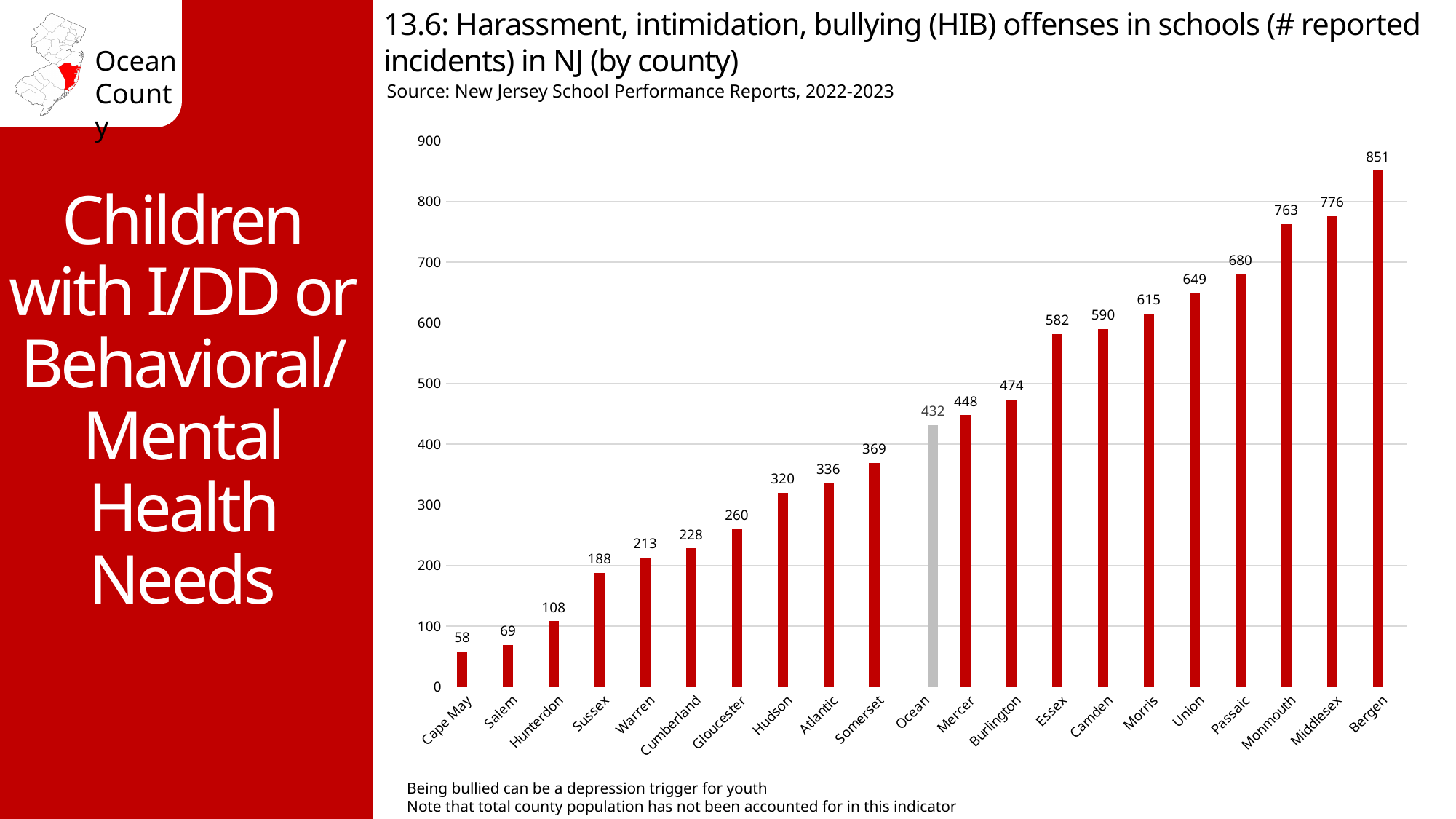
What kind of chart is shown on the slide? Bar chart Which county has the lowest number of reported HIB incidents? Cape May What is the difference in reported HIB incidents between Middlesex and Monmouth? 13 Which bar is shown in a different colour (grey) from the others? Ocean Which county has the highest number of reported HIB incidents? Bergen What is the difference in reported HIB incidents between Bergen and Ocean? 419 What is the number of reported HIB incidents for Ocean County? 432 Is the value for Monmouth greater or less than 700? greater Do the values rise or fall moving from left to right along the x axis? Rise How many counties are shown on the chart? 21 What is the number of reported HIB incidents for Hudson County? 320 Which county has more reported HIB incidents, Essex or Camden? Camden